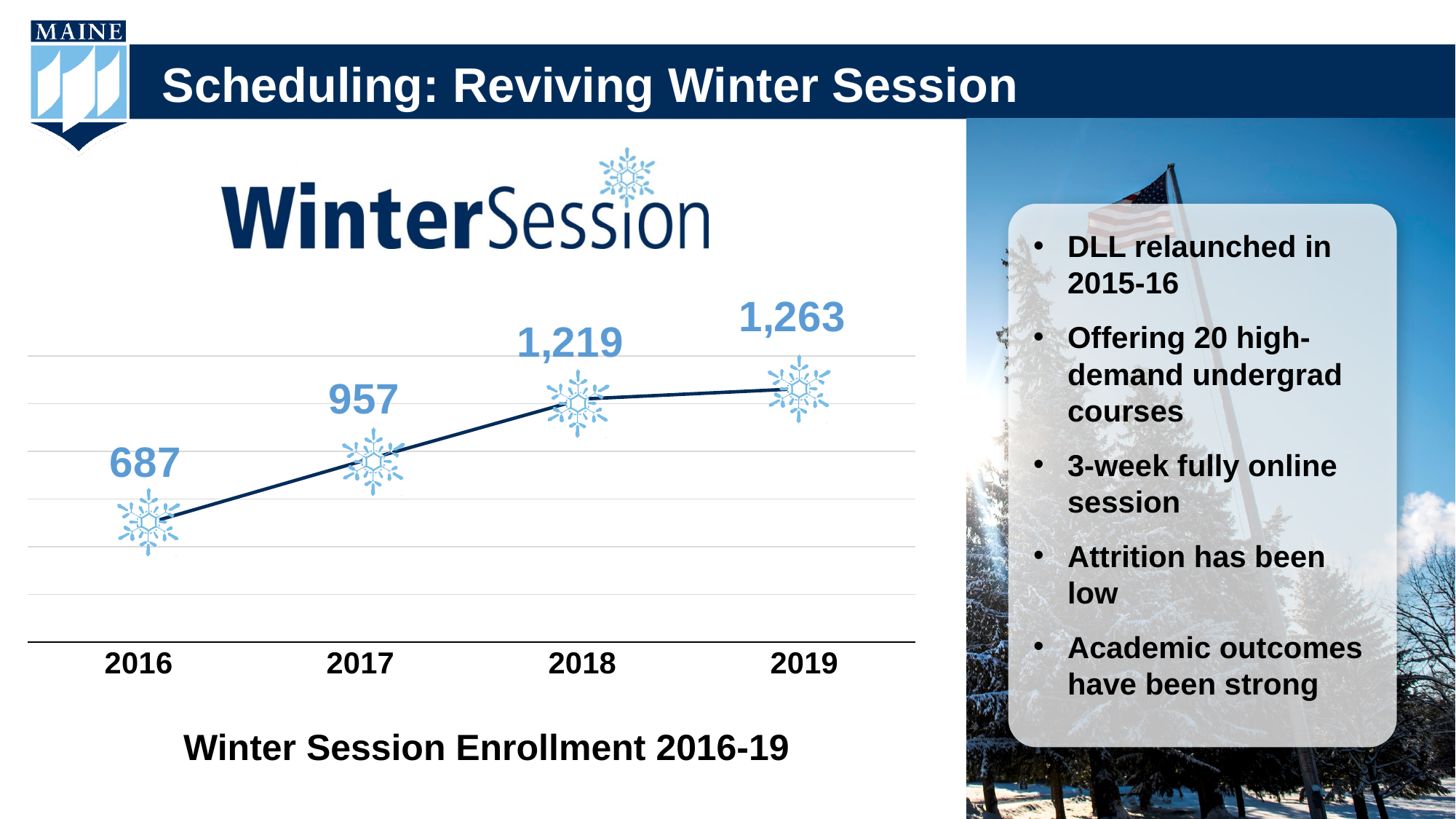
What was the Winter Session enrollment in 2019? 1,263 Does Winter Session enrollment rise or fall from 2016 to 2019? Rise What was the Winter Session enrollment in 2016? 687 Which year had the highest Winter Session enrollment? 2019 What kind of chart is used to show Winter Session enrollment? Line chart Was enrollment higher in 2017 or in 2018? 2018 What was the Winter Session enrollment in 2018? 1,219 What was the Winter Session enrollment in 2017? 957 What is the difference in enrollment between 2017 and 2018? 262 By how much did Winter Session enrollment increase from 2016 to 2019? 576 How many years are plotted on the chart? 4 Which year had the lowest Winter Session enrollment? 2016